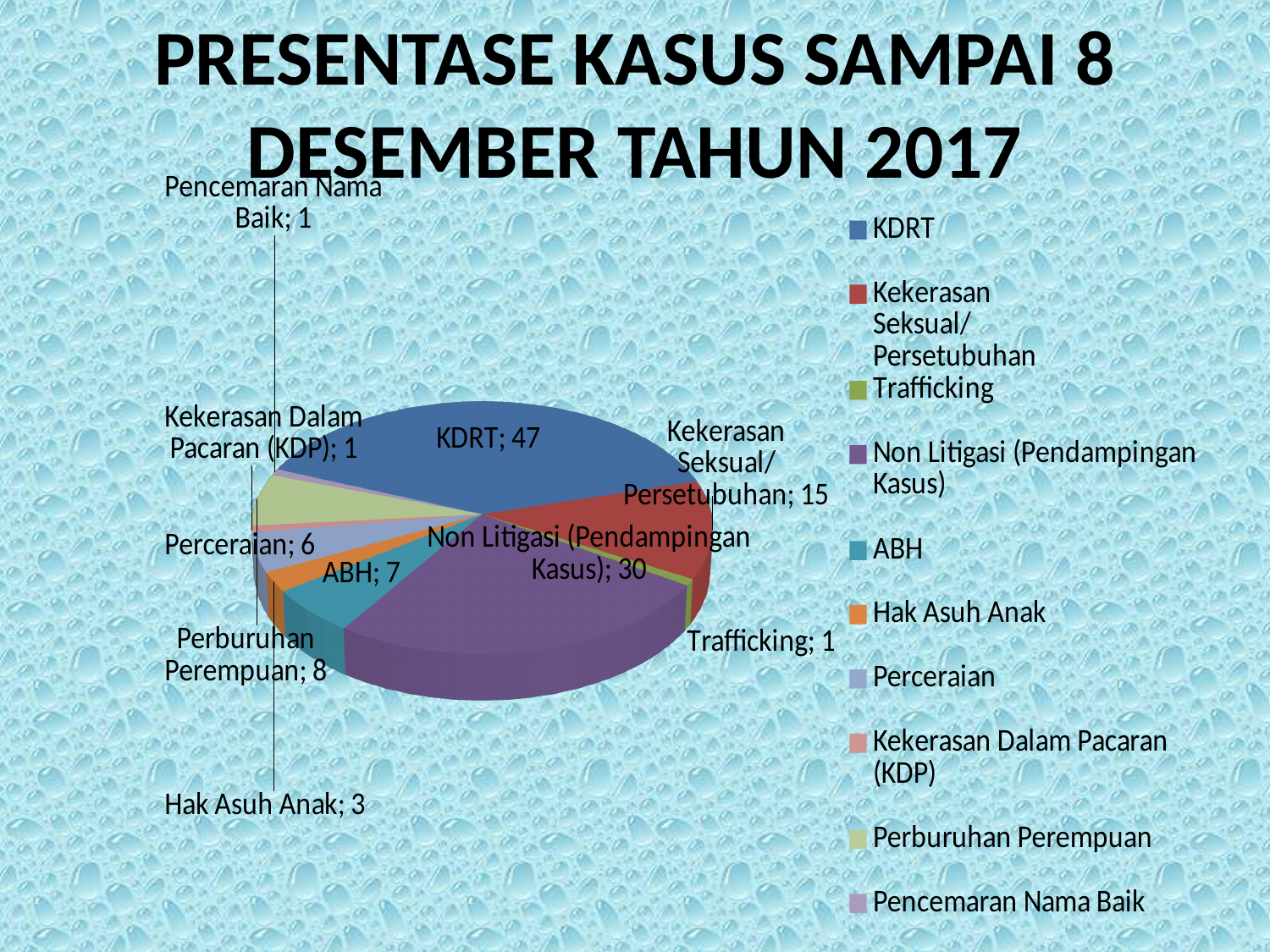
What kind of chart is shown on the slide? Pie chart What is the value shown for KDRT in the pie chart? 47 Which is larger, the value for Perceraian or the value for ABH? ABH What is the value shown for Hak Asuh Anak? 3 What is the value shown for ABH? 7 Which category has the largest slice of the pie chart? KDRT What is the value shown for Non Litigasi (Pendampingan Kasus)? 30 What is the value shown for Kekerasan Seksual/Persetubuhan? 15 What is the value shown for Perburuhan Perempuan? 8 What is the difference between the values for KDRT and Non Litigasi (Pendampingan Kasus)? 17 What is the title of the slide? PRESENTASE KASUS SAMPAI 8 DESEMBER TAHUN 2017 How many categories are shown in the pie chart? 10